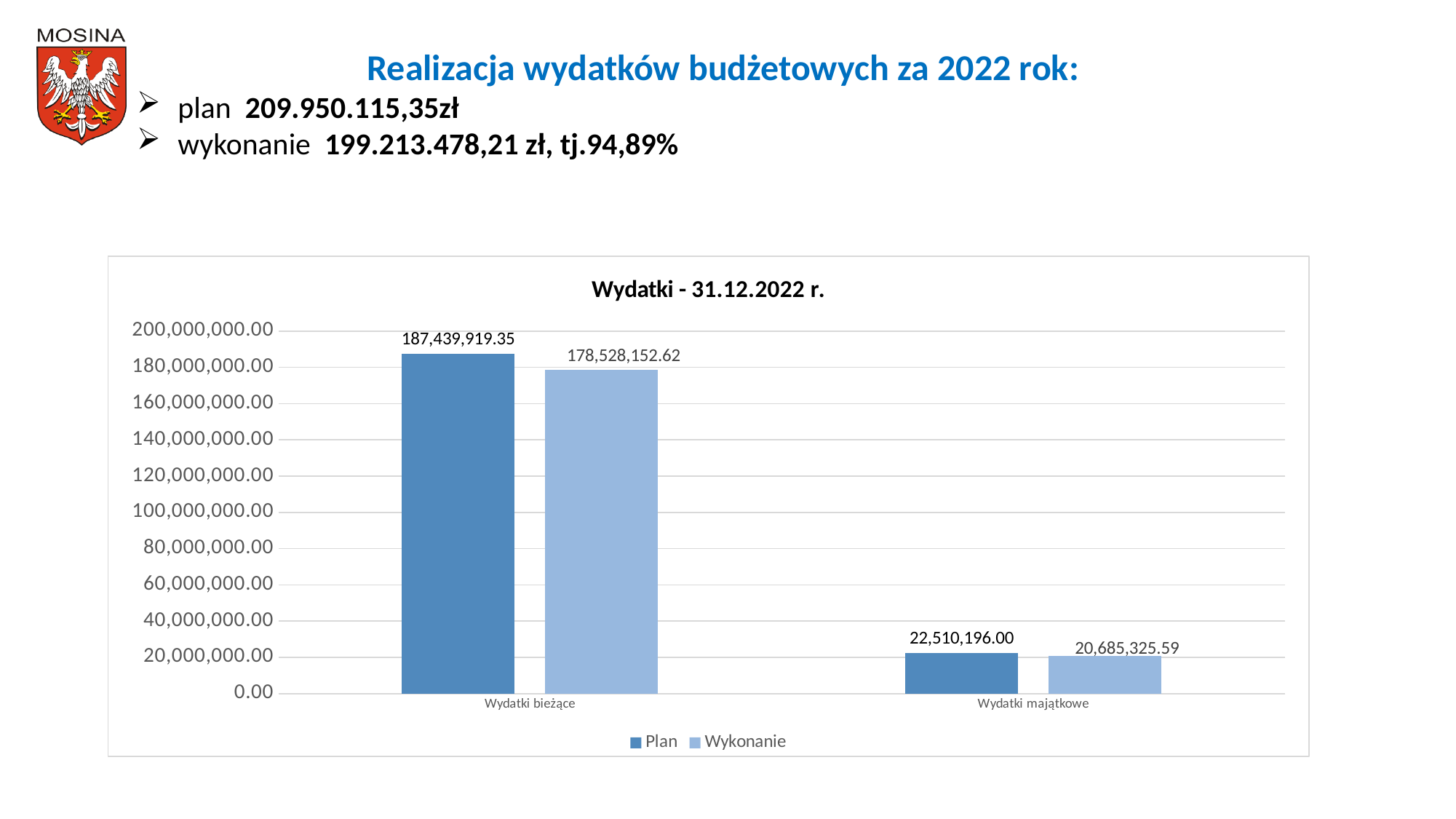
What is the title of the chart? Wydatki - 31.12.2022 r. For Wydatki majątkowe, which is larger: Plan or Wykonanie? Plan Which category has the lowest Wykonanie value? Wydatki majątkowe What is the Plan value for Wydatki majątkowe? 22,510,196.00 What is the Plan value for Wydatki bieżące? 187,439,919.35 What is the Wykonanie value for Wydatki majątkowe? 20,685,325.59 Which category has the highest Plan value? Wydatki bieżące What is the Wykonanie value for Wydatki bieżące? 178,528,152.62 What is the difference between the Plan and Wykonanie values for Wydatki majątkowe? 1,824,870.41 How many series does the chart legend list? 2 How many categories are shown on the x axis of the chart? 2 What is the difference between the Plan and Wykonanie values for Wydatki bieżące? 8,911,766.73